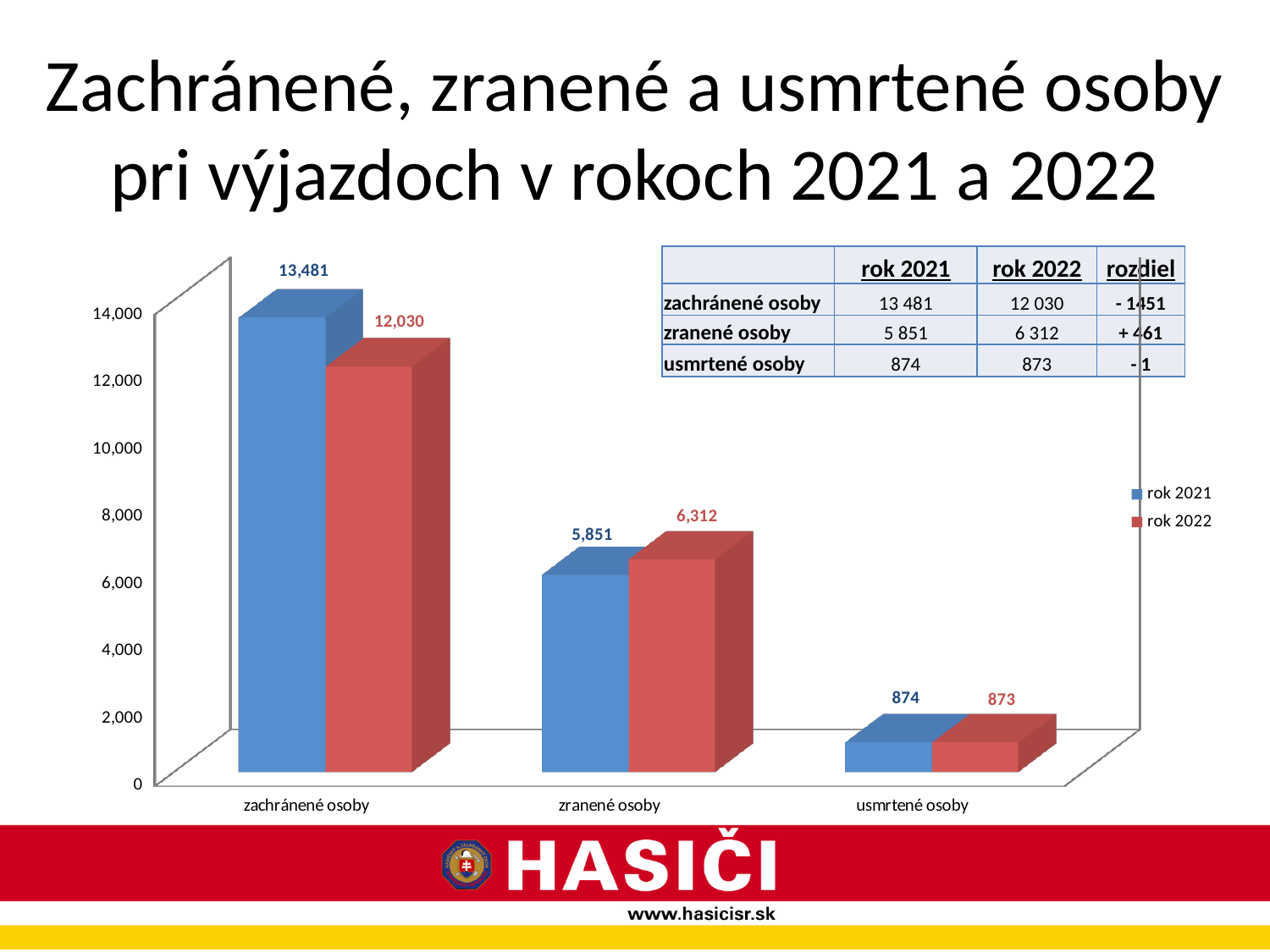
For zranené osoby, which year has the larger value, rok 2021 or rok 2022? rok 2022 What is the difference between the rok 2022 and rok 2021 values for zranené osoby? 461 What is the value for usmrtené osoby in rok 2021? 874 What is the value for zachránené osoby in rok 2021? 13,481 Which category has the highest value in rok 2022? zachránené osoby What is the difference between the rok 2021 and rok 2022 values for zachránené osoby? 1,451 What is the value for zranené osoby in rok 2022? 6,312 What kind of chart is shown on the slide? bar chart How many series does the chart legend list? 2 Is the value for zachránené osoby in rok 2022 greater or less than 10,000? greater How many categories are shown on the x axis of the chart? 3 Which category has the lowest value in rok 2021? usmrtené osoby